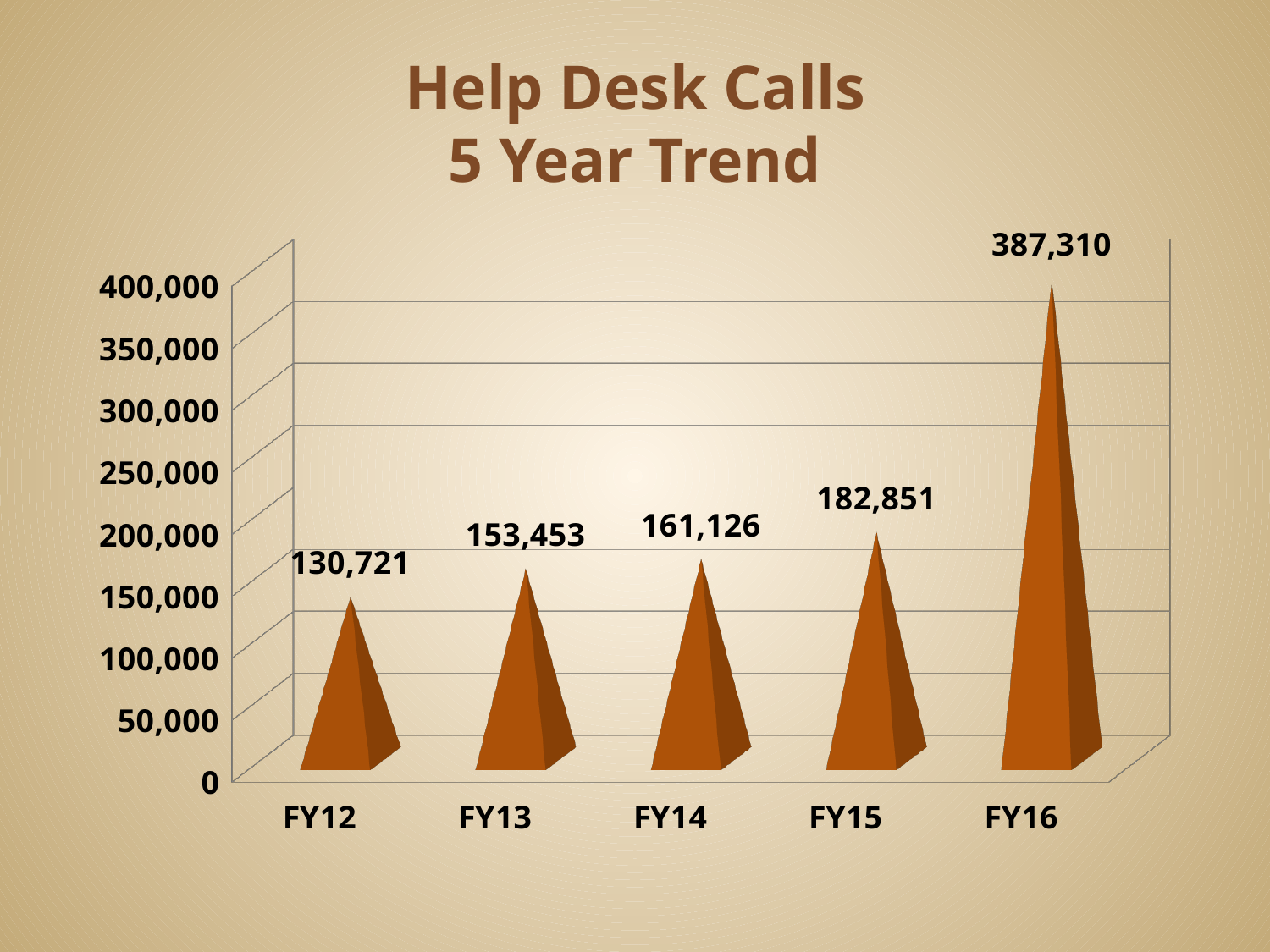
Which fiscal year has the lowest number of help desk calls? FY12 What is the difference between the values for FY13 and FY12? 22,732 What is the value for FY14? 161,126 Do the values rise or fall from FY12 to FY16? rise What kind of chart is shown on the slide? bar chart What is the value for FY12? 130,721 How many fiscal years are shown on the chart? 5 Is the value for FY15 greater or less than 200,000? less What is the value for FY16? 387,310 What is the difference between the values for FY16 and FY15? 204,459 Which fiscal year has the highest number of help desk calls? FY16 Which is larger, the value for FY14 or the value for FY13? FY14